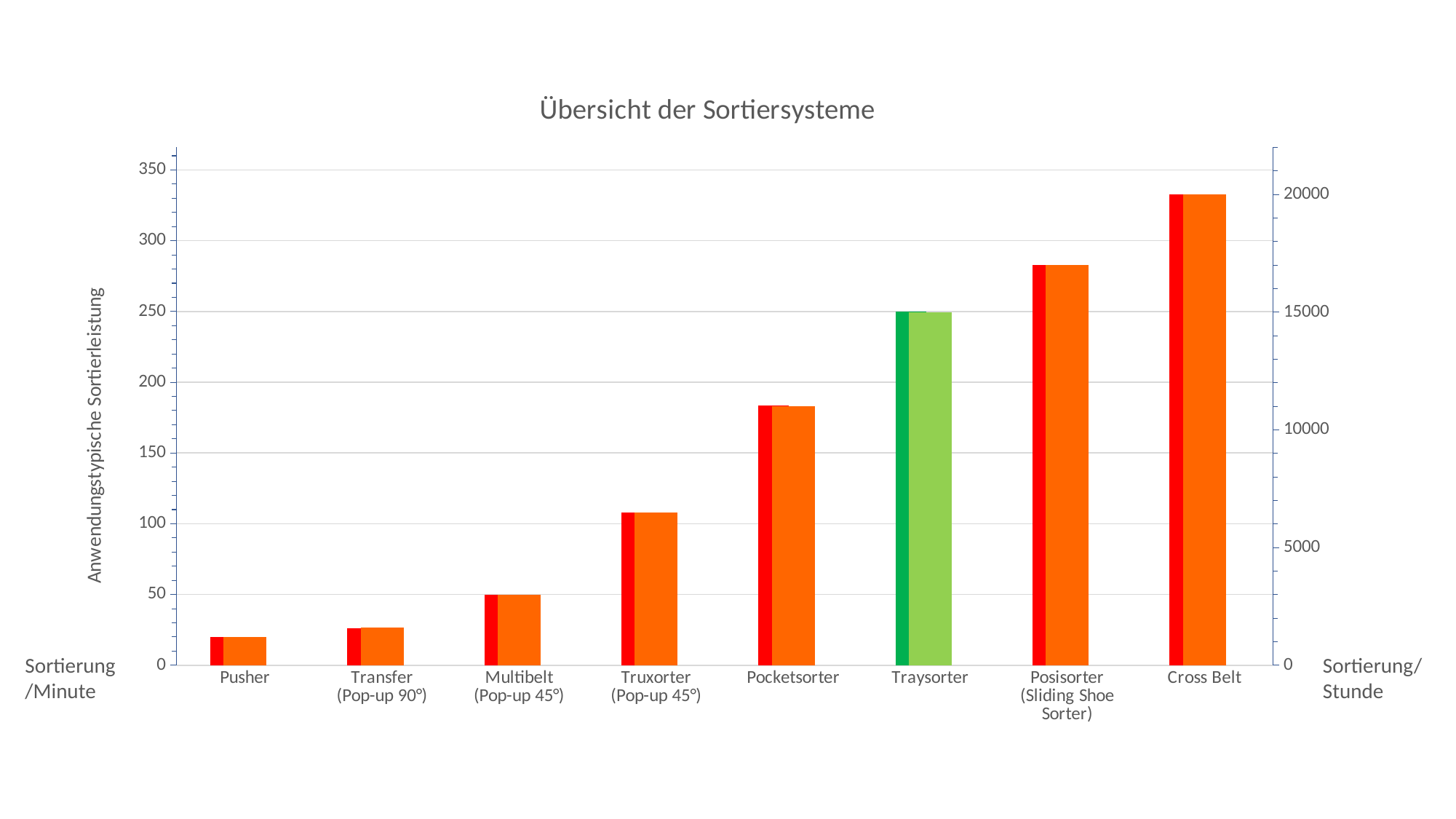
What is the value for Traysorter on the left axis (Sortierung/Minute)? 250 Do the values rise or fall from left to right along the x axis? rise Which sorting system has the lowest value? Pusher Is the value for Truxorter (Pop-up 45°) on the left axis greater or less than 150? less What kind of chart is shown on the slide? bar chart What is the value for Multibelt (Pop-up 45°) on the left axis (Sortierung/Minute)? 50 What is the title of the chart? Übersicht der Sortiersysteme How many sorting systems (categories) are shown on the x axis? 8 Which has a larger value, Posisorter (Sliding Shoe Sorter) or Pocketsorter? Posisorter (Sliding Shoe Sorter) Which sorting system has the highest value? Cross Belt What is the value for Cross Belt on the right axis (Sortierung/Stunde)? 20000 Is the value for Pocketsorter on the left axis greater or less than 150? greater